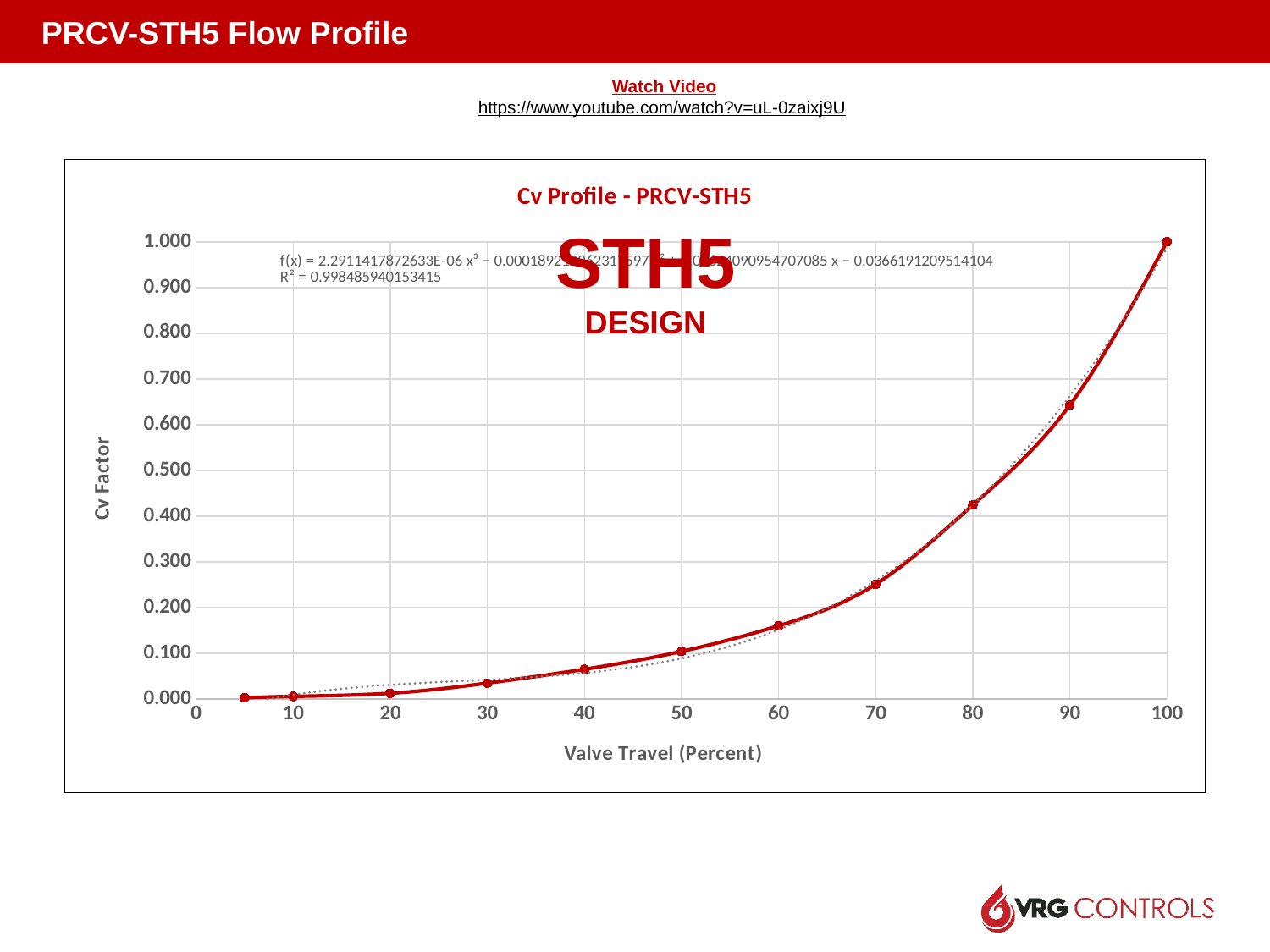
Is the Cv Factor at 70 percent valve travel greater or less than 0.300? less Does the Cv Factor rise or fall as valve travel increases? rise Which has the larger Cv Factor, 60 percent or 80 percent valve travel? 80 percent How many data points are plotted on the line? 11 At which valve travel percentage is the Cv Factor lowest? 5 Is the Cv Factor at 80 percent valve travel greater or less than 0.400? greater Is the Cv Factor at 90 percent valve travel greater or less than 0.600? greater What is the Cv Factor at 100 percent valve travel? 1.000 What is the label of the x axis? Valve Travel (Percent) What is the title of the chart? Cv Profile - PRCV-STH5 At which valve travel percentage is the Cv Factor highest? 100 What kind of chart is shown on the slide? line chart